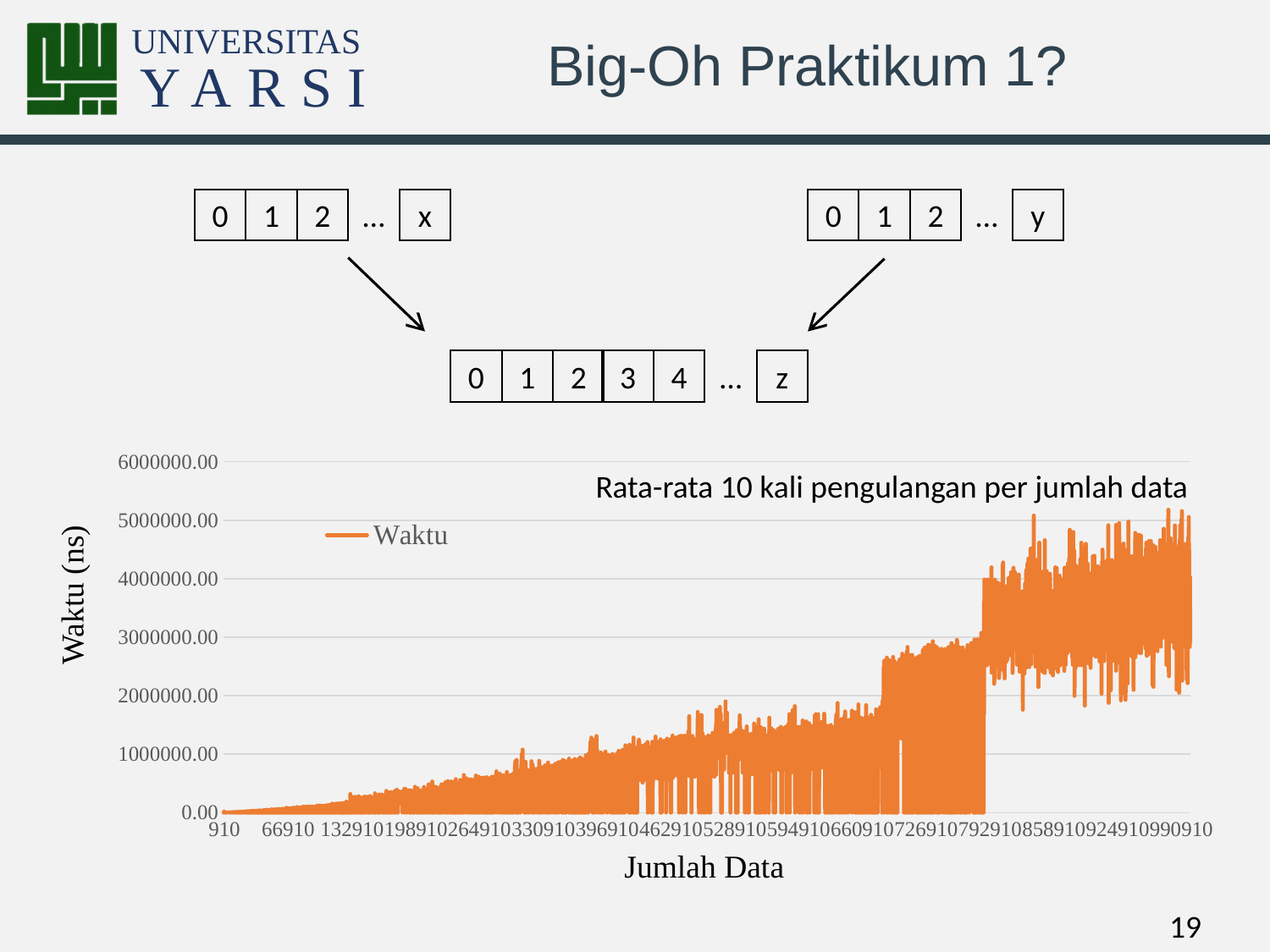
Is the value for Waktu at Jumlah Data 198910 greater or less than 3000000.00? less Is the value for Waktu at Jumlah Data 330910 greater or less than 2000000.00? less What is the title of the chart? Rata-rata 10 kali pengulangan per jumlah data What kind of chart is shown on the slide? line chart Is the value for Waktu at Jumlah Data 66910 greater or less than 1000000.00? less What is the name of the series shown in the chart legend? Waktu How many series does the chart legend list? 1 Do the values of Waktu generally rise or fall as Jumlah Data increases along the x axis? rise